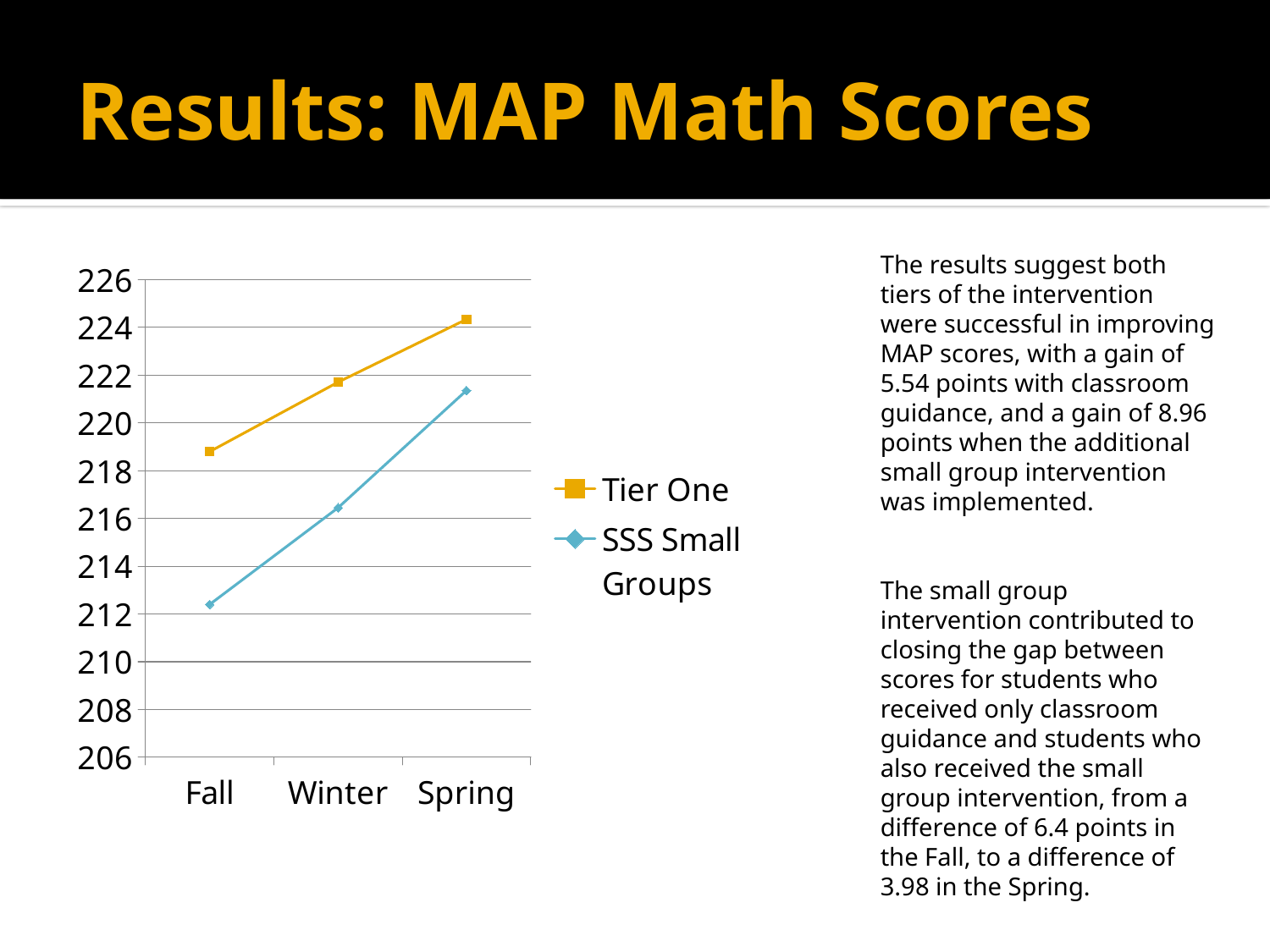
At which time point is the Tier One score highest? Spring In Fall, which series has the higher score, Tier One or SSS Small Groups? Tier One Is the Tier One value for Winter greater or less than 222? less How many time points are plotted along the x axis? 3 At which time point is the SSS Small Groups score lowest? Fall Is the SSS Small Groups value for Spring greater or less than 222? less How many series does the legend list? 2 Do the Tier One scores rise or fall from Fall to Spring? rise What are the two series named in the legend? Tier One and SSS Small Groups What kind of chart is shown on the slide? line chart Do the SSS Small Groups scores rise or fall from Fall to Spring? rise Is the SSS Small Groups value for Fall greater or less than 214? less